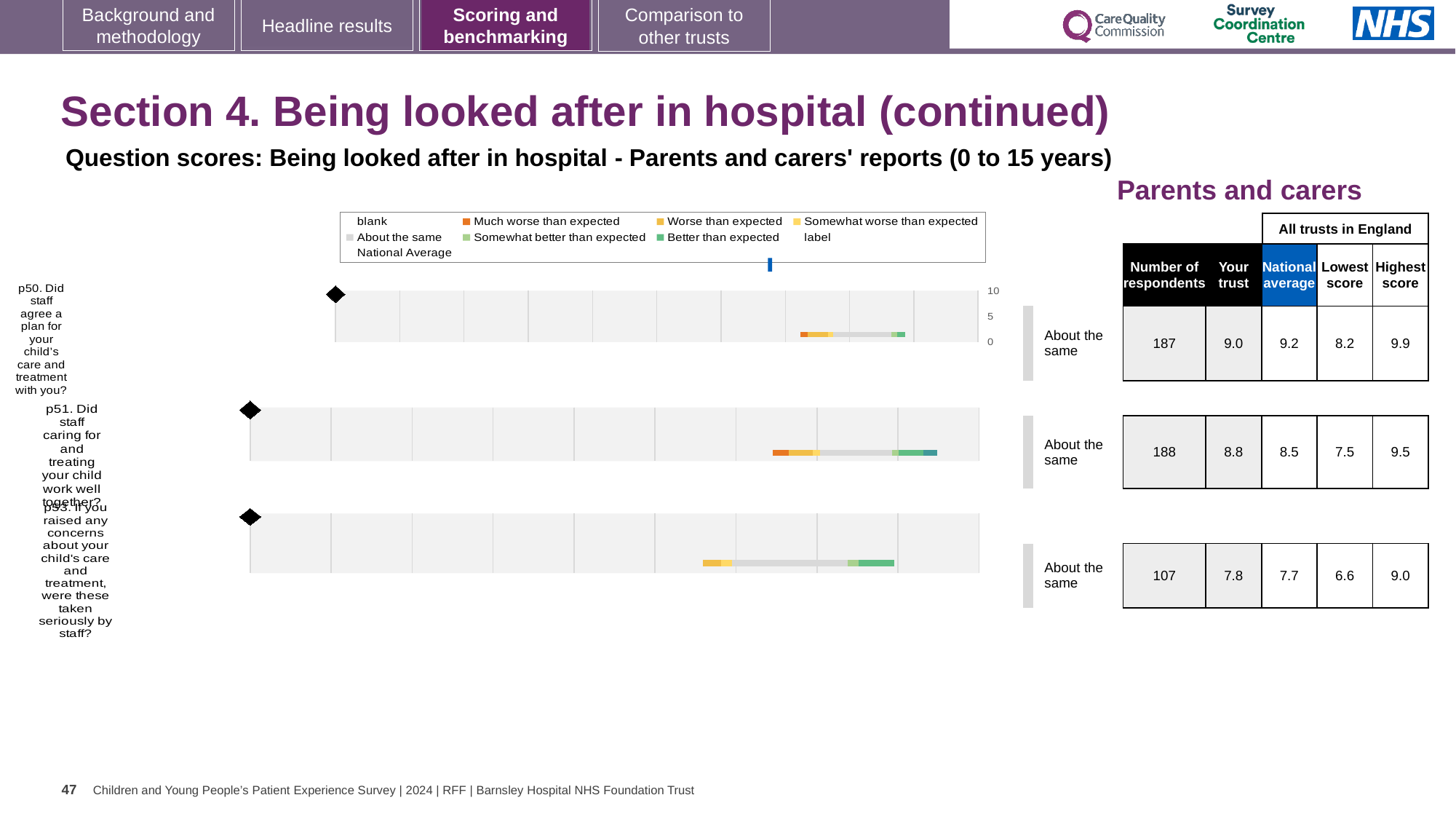
For p51, is the 'Your trust' score or the National average larger in the table next to the charts? Your trust In the table next to the charts, what is the 'Your trust' score for p50 (Did staff agree a plan for your child's care and treatment with you)? 9.0 What is the difference between the National average and the 'Your trust' score for p50 in the table next to the charts? 0.2 In the table next to the charts, what is the National average for p51 (Did staff caring for and treating your child work well together)? 8.5 Which of the three questions has the lowest 'Your trust' score in the table next to the charts? p53 What benchmarking category is shown beside the chart for p50? About the same What kind of chart is used to show the benchmarking for each question on this slide? bar chart In the table next to the charts, what is the Highest score for p53 (If you raised any concerns about your child's care and treatment, were these taken seriously by staff)? 9.0 How many questions (p50, p51, p53) have a benchmarking bar chart on this slide? 3 How many respondents answered p53 according to the table next to the charts? 107 Which of the three questions has the highest number of respondents in the table next to the charts? p51 What does the legend entry with the orange colour represent in the benchmarking charts? Much worse than expected